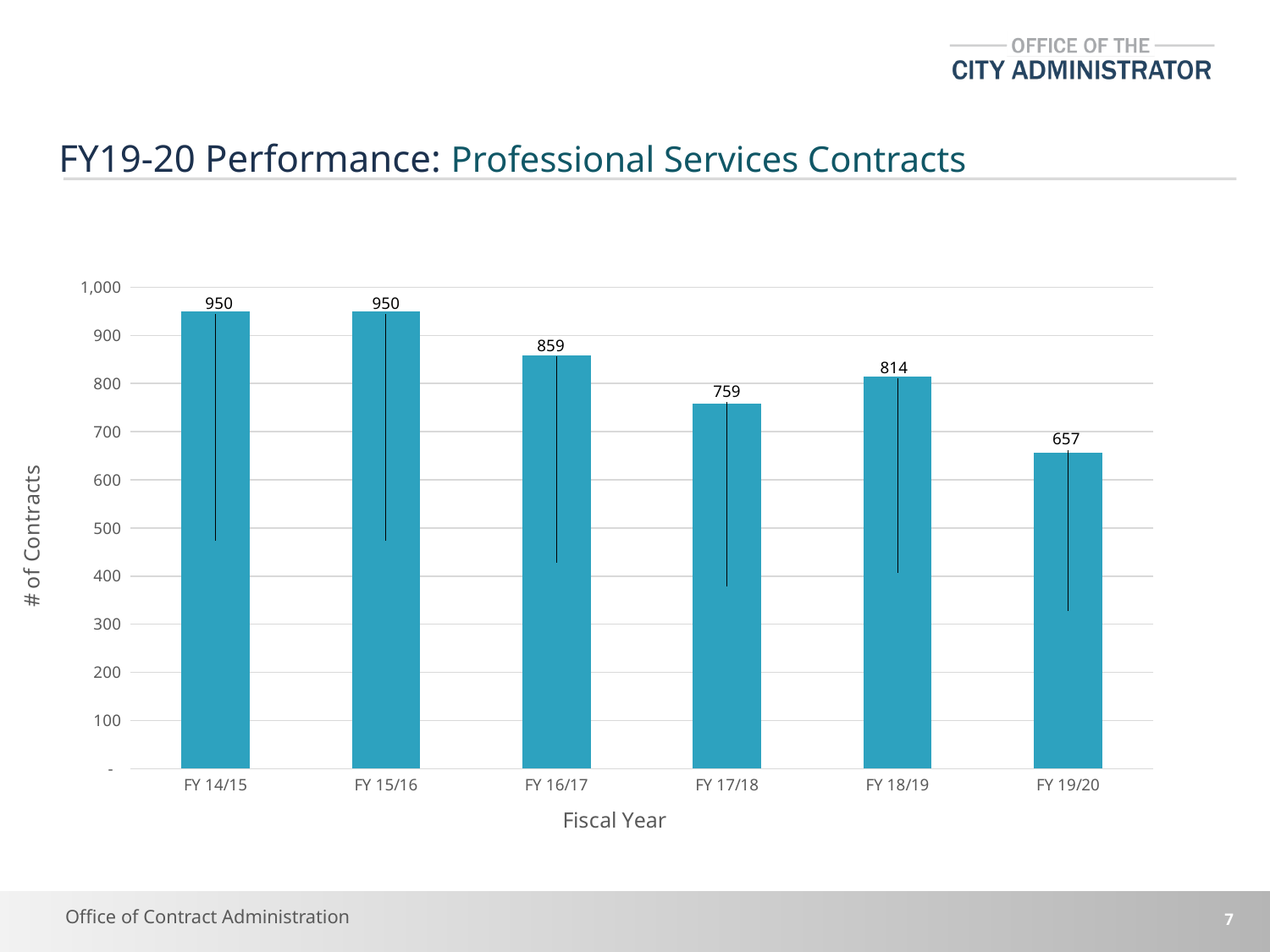
What kind of chart is shown on the slide? bar chart Which fiscal year has the lowest number of contracts? FY 19/20 Do the values generally rise or fall from FY 14/15 to FY 19/20? fall What is the label of the vertical axis? # of Contracts How many professional services contracts were there in FY 16/17? 859 Is the value for FY 17/18 greater or less than 800? less What is the difference between the values for FY 18/19 and FY 17/18? 55 What is the value for FY 18/19? 814 Which is larger, the value for FY 17/18 or FY 18/19? FY 18/19 What is the difference between the values for FY 14/15 and FY 19/20? 293 What is the value for FY 19/20? 657 How many fiscal years are shown on the chart? 6